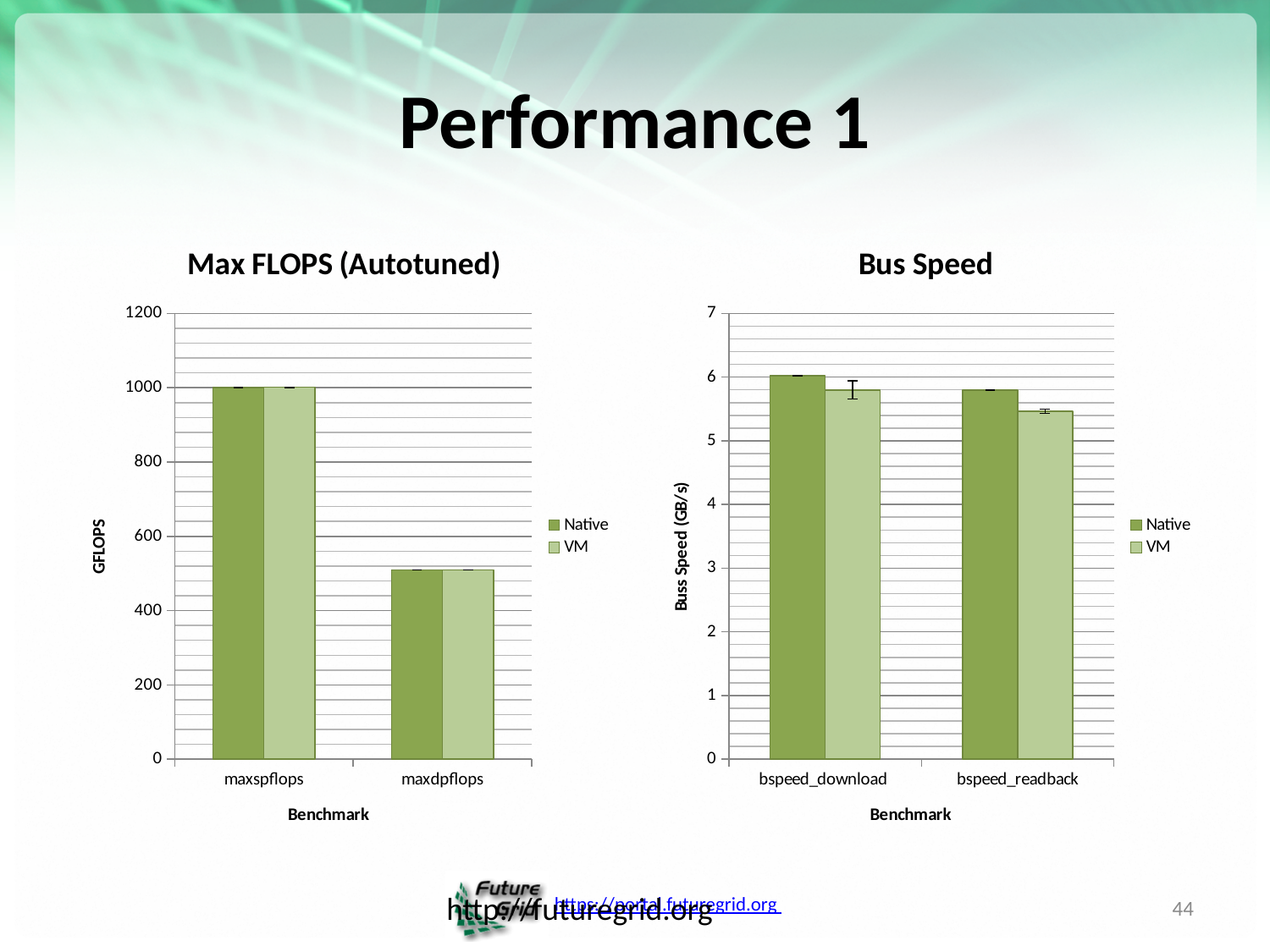
In the Max FLOPS (Autotuned) chart, is the Native value for maxspflops greater or less than 800? greater How many series does the legend of the Bus Speed chart list? 2 In the Bus Speed chart, which bar is the lowest? VM for bspeed_readback What kind of chart is the Max FLOPS (Autotuned) chart? bar chart In the Bus Speed chart, is the VM value for bspeed_readback greater or less than 6? less In the Bus Speed chart, which series has the larger value for bspeed_readback, Native or VM? Native In the Max FLOPS (Autotuned) chart, is the VM value for maxdpflops greater or less than 600? less How many benchmark categories are shown on the x axis of the Max FLOPS (Autotuned) chart? 2 What is the y-axis label of the Max FLOPS (Autotuned) chart? GFLOPS In the Max FLOPS (Autotuned) chart, which benchmark has the higher Native value, maxspflops or maxdpflops? maxspflops What is the y-axis label of the Bus Speed chart? Buss Speed (GB/s)